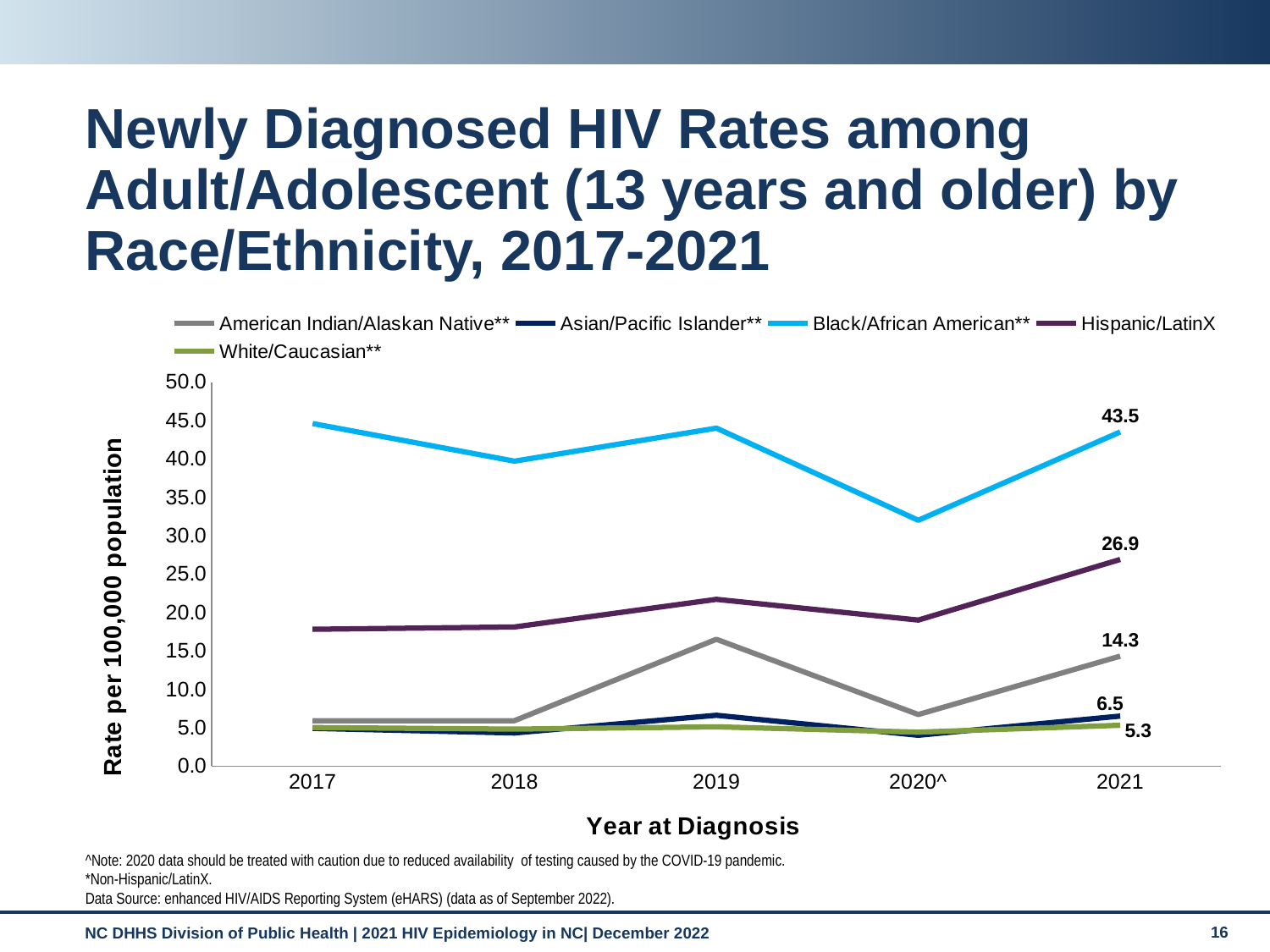
What is the rate for White/Caucasian in 2021? 5.3 Which race/ethnicity has the highest rate in 2021? Black/African American What is the rate for American Indian/Alaskan Native in 2021? 14.3 What is the rate for Black/African American in 2021? 43.5 How many series does the legend list? 5 What is the label of the y axis? Rate per 100,000 population Is the rate for Black/African American in 2020 greater or less than 35.0? less Which race/ethnicity has the lowest rate in 2021? White/Caucasian How many years are shown on the x axis? 5 What is the difference between the 2021 rates for Black/African American and Hispanic/LatinX? 16.6 What type of chart is shown on the slide? line chart What is the rate for Hispanic/LatinX in 2021? 26.9